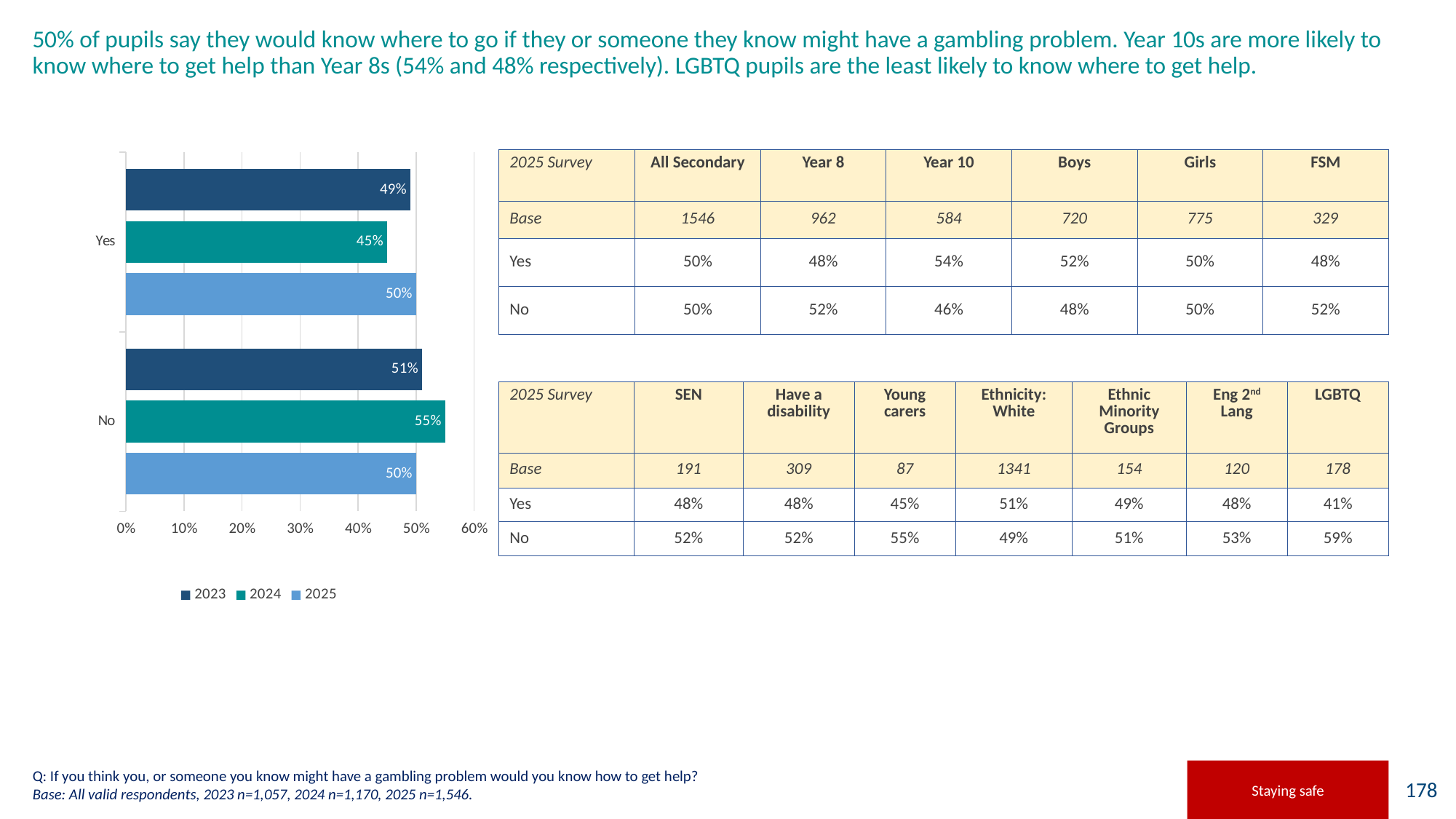
What kind of chart is shown on the slide? bar chart Which is larger: the 2023 value for 'Yes' or the 2023 value for 'No'? No Does the 'Yes' value rise or fall from 2023 to 2024? fall Which year has the highest value for 'No'? 2024 Which year has the lowest value for 'Yes'? 2024 What is the difference between the 2024 'No' value and the 2024 'Yes' value? 10 percentage points What is the value for 'Yes' in the 2025 series? 50% What is the value for 'Yes' in the 2024 series? 45% How many categories are shown on the chart's vertical axis? 2 How many series does the chart legend list? 3 Which series is shown in the darkest blue colour in the legend? 2023 What is the value for 'No' in the 2023 series? 51%